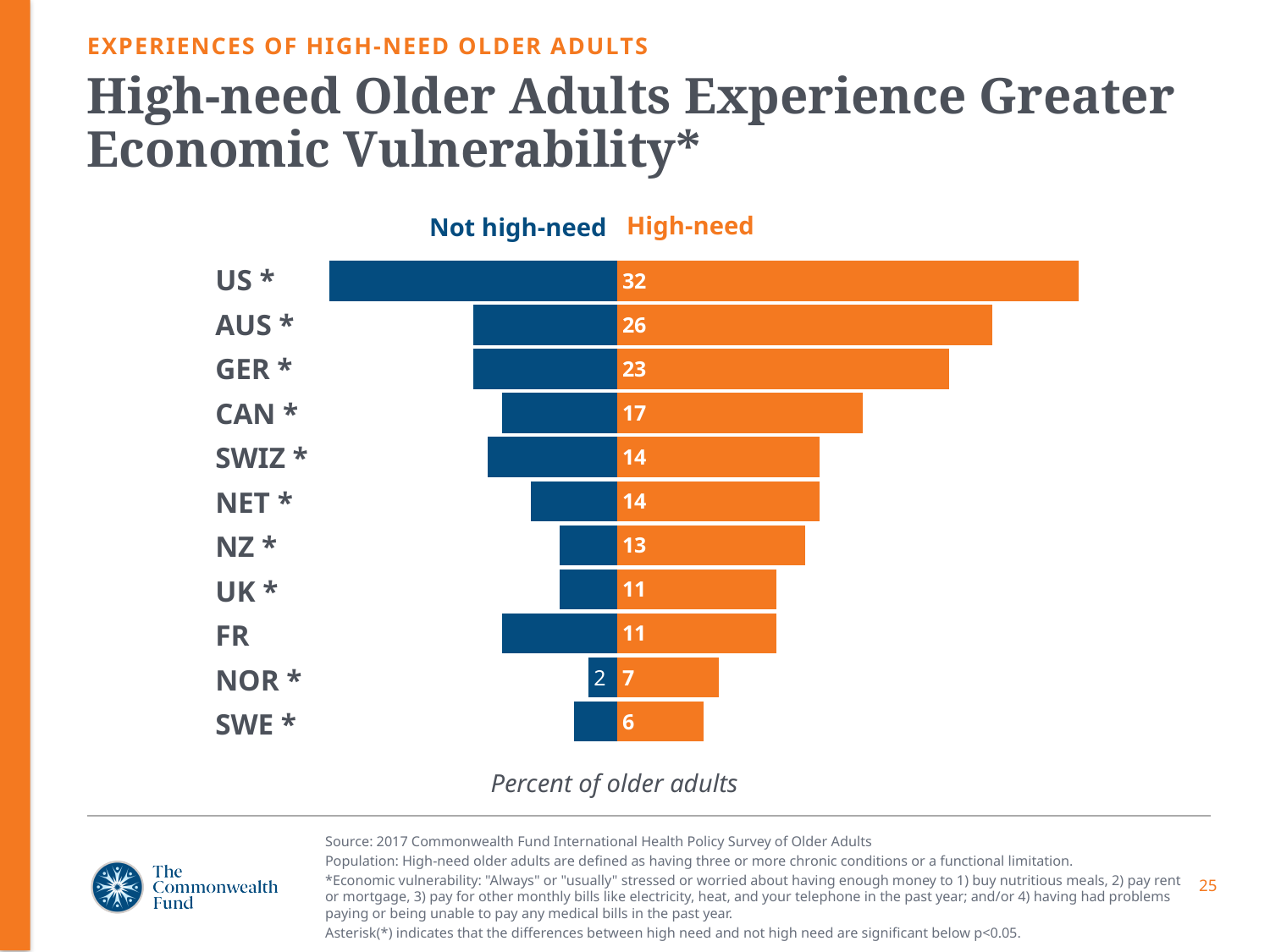
Which has a larger High-need value, GER or CAN? GER Which has a longer Not high-need bar, US or SWE? US How many countries are shown in the chart? 11 What is the High-need value for GER? 23 Which country has the highest High-need value? US What is the High-need value for US? 32 How many series does the legend list? 2 What is the Not high-need value for NOR? 2 What is the difference between the High-need values for US and AUS? 6 Which country has the lowest High-need value? SWE For NOR, what is the difference between the High-need and Not high-need values? 5 What type of chart is shown on the slide? Bar chart